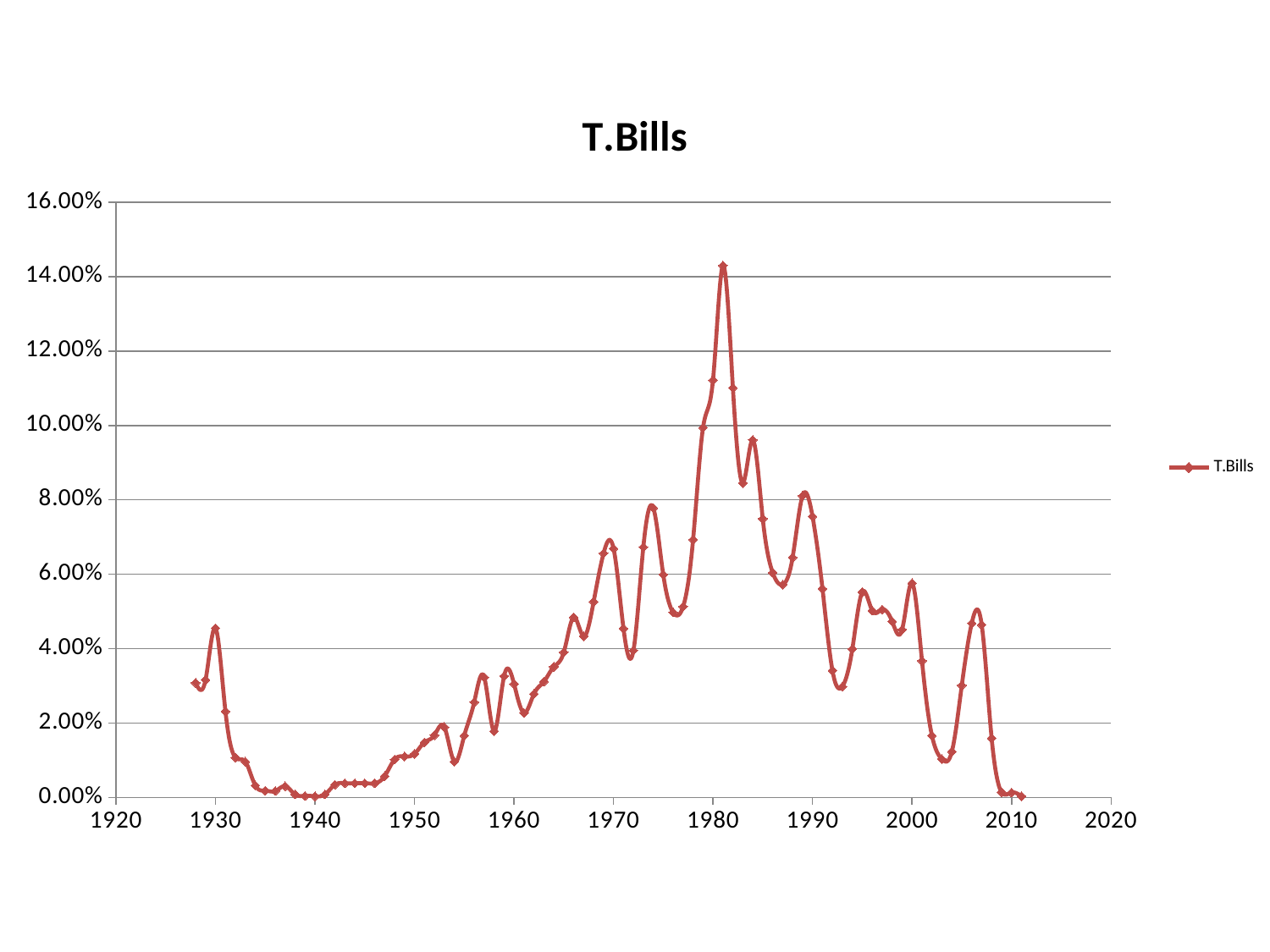
Is the peak T.Bills value around 1981 greater or less than 12.00%? greater What is the title of the chart? T.Bills Is the T.Bills value at 1960 greater or less than 6.00%? less Do T.Bills values generally rise or fall between 1940 and 1980? rise Is the T.Bills value at 1940 greater or less than 2.00%? less What is the name of the series shown in the legend? T.Bills What kind of chart is shown on the slide? line chart Between which two labelled x-axis years does the highest T.Bills value occur? 1980 and 1990 How many series does the legend list? 1 Which is larger, the T.Bills value at 1980 or the value at 1950? 1980